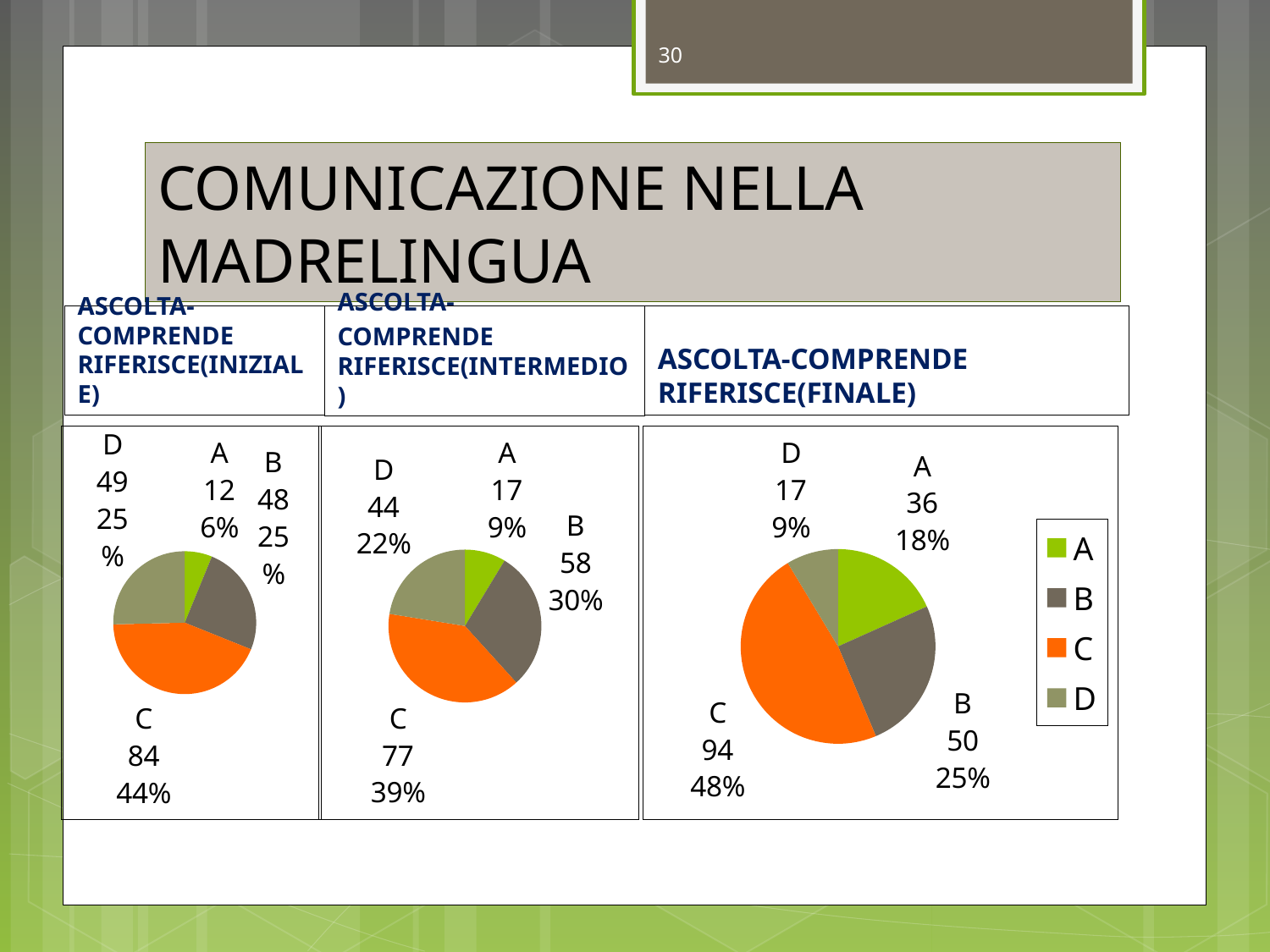
In the ASCOLTA-COMPRENDE RIFERISCE(FINALE) pie chart, which is larger, the value for B or the value for D? B In the ASCOLTA-COMPRENDE RIFERISCE(FINALE) pie chart, what is the value for A? 36 According to the legend, which colour represents category C? orange How many entries does the legend on the right of the slide list? 4 In the ASCOLTA-COMPRENDE RIFERISCE(FINALE) pie chart, which category has the largest slice? C In the ASCOLTA-COMPRENDE RIFERISCE(INTERMEDIO) pie chart, what is the difference between the values for C and D? 33 In the ASCOLTA-COMPRENDE RIFERISCE(FINALE) pie chart, what share is shown for D? 9% In the ASCOLTA-COMPRENDE RIFERISCE(INTERMEDIO) pie chart, what percentage is shown for B? 30% What kind of chart is used in the ASCOLTA-COMPRENDE RIFERISCE(FINALE) panel? pie chart In the ASCOLTA-COMPRENDE RIFERISCE(INIZIALE) pie chart, which category has the smallest slice? A How many slices does the ASCOLTA-COMPRENDE RIFERISCE(INTERMEDIO) pie chart have? 4 In the ASCOLTA-COMPRENDE RIFERISCE(INIZIALE) pie chart, what is the value for C? 84